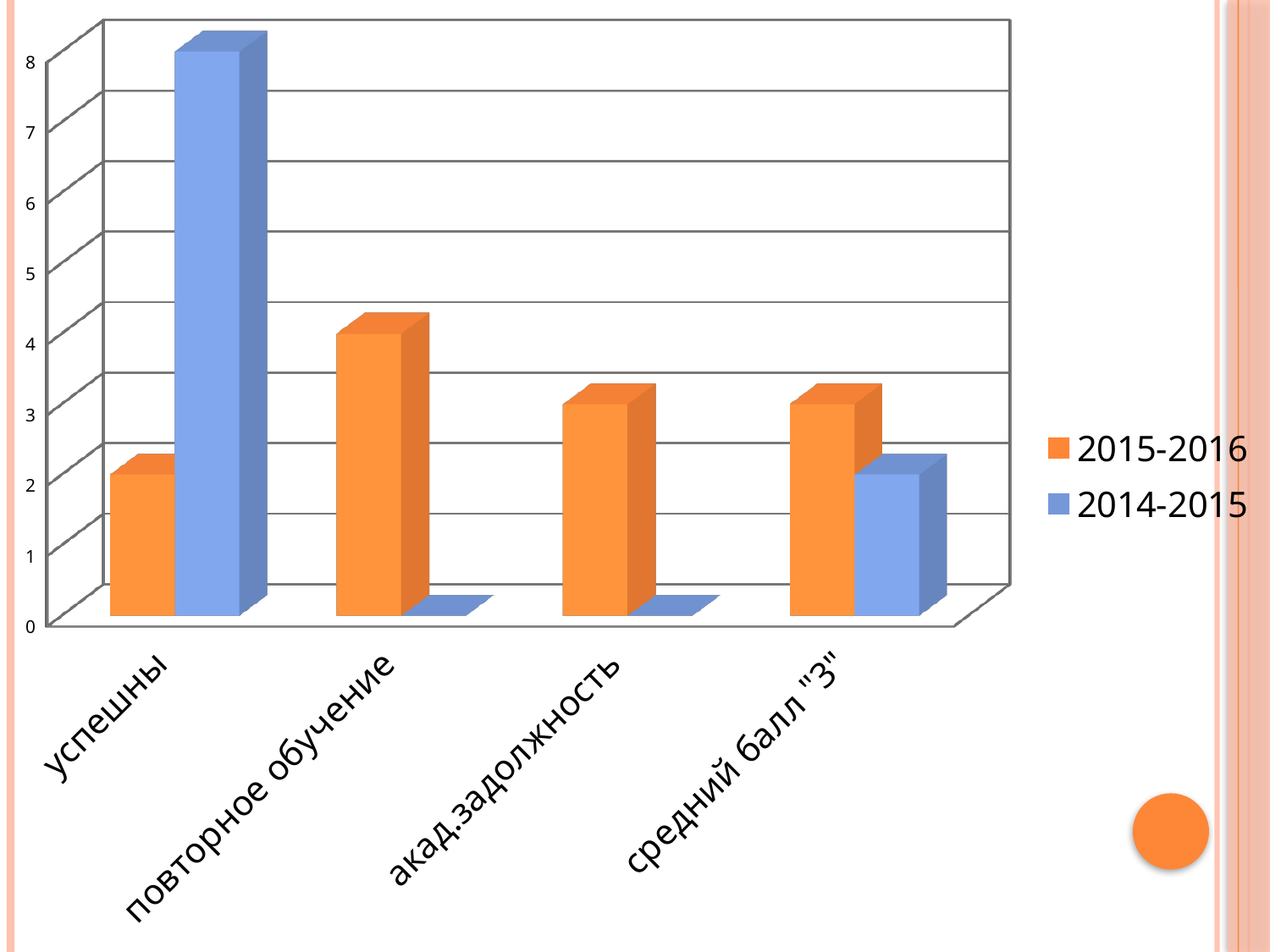
What kind of chart is shown on the slide? bar chart Which category has the highest value for the 2014-2015 series? успешны Is the 2014-2015 value for успешны greater or less than 6? greater Which category has the lowest value for the 2015-2016 series? успешны For the category успешны, which series has the larger value, 2015-2016 or 2014-2015? 2014-2015 For the category повторное обучение, which series has the larger value, 2015-2016 or 2014-2015? 2015-2016 Is the 2015-2016 value for успешны greater or less than 3? less Which colour represents the 2014-2015 series in the legend? blue Which category has the highest value for the 2015-2016 series? повторное обучение Is the 2015-2016 value for повторное обучение greater or less than 3? greater How many series does the legend list? 2 How many categories are shown on the x axis? 4